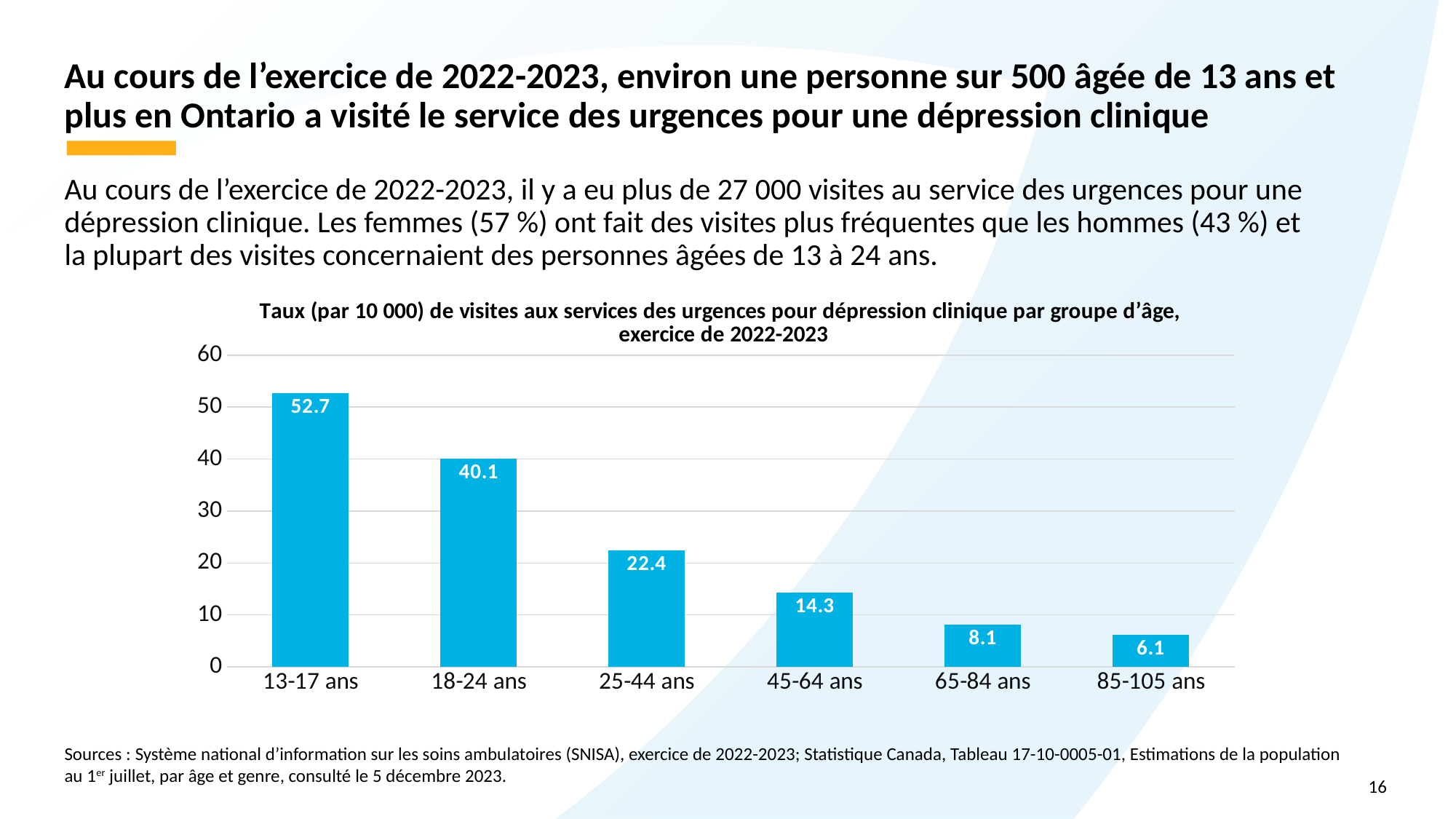
What is the difference between the rates for the 25-44 ans and 65-84 ans age groups? 14.3 What is the value shown for the 45-64 ans age group? 14.3 Do the values rise or fall as age group increases along the x axis? Fall How many age groups are shown in the chart? 6 What is the rate of emergency department visits for clinical depression for the 13-17 ans age group? 52.7 What is the difference between the rates for the 13-17 ans and 18-24 ans age groups? 12.6 Which age group has the highest rate of emergency department visits? 13-17 ans Which age group has the lowest rate of emergency department visits? 85-105 ans Which age group has a higher rate: 18-24 ans or 25-44 ans? 18-24 ans What is the value shown for the 85-105 ans age group? 6.1 What kind of chart is shown on the slide? Bar chart Is the value for the 18-24 ans age group greater or less than 30? greater